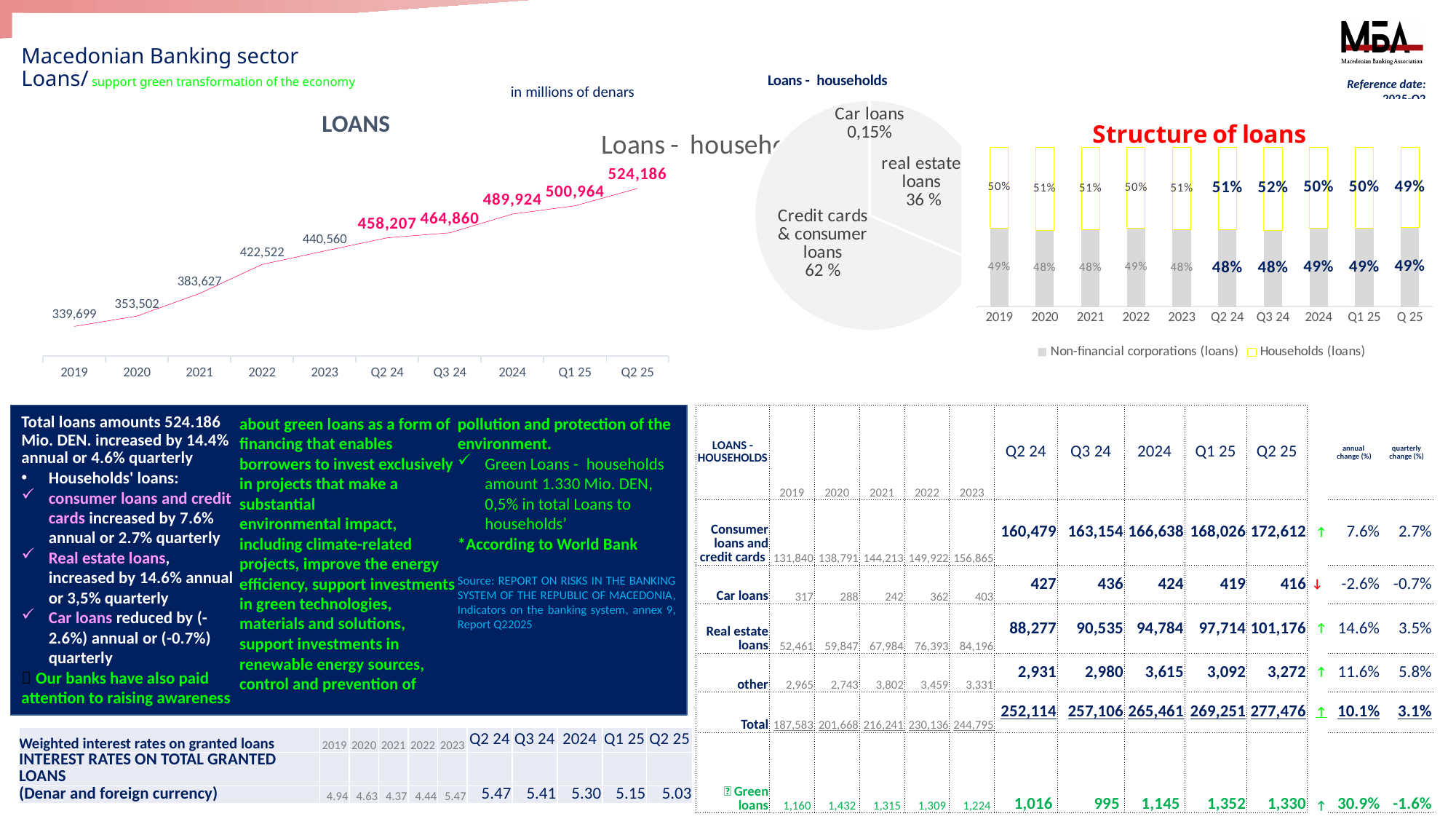
How many series does the legend of the Structure of loans chart list? 2 In the Loans - households pie chart, which slice is the largest? Credit cards & consumer loans In the LOANS chart, do the values rise or fall from 2019 to Q2 25? rise In the Loans - households pie chart, what share do real estate loans have? 36 % In the LOANS chart, what is the difference between the values for Q2 25 and Q1 25? 23,222 In the LOANS chart, what is the value for 2019? 339,699 What kind of chart is the LOANS chart? line chart In the LOANS chart, which period has the highest value? Q2 25 How many data points are plotted in the LOANS chart? 10 In the Structure of loans chart, what is the value for Non-financial corporations (loans) in Q3 24? 48% In the Structure of loans chart, what is the value for Households (loans) in 2019? 50% In the LOANS chart, what is the value for Q2 25? 524,186